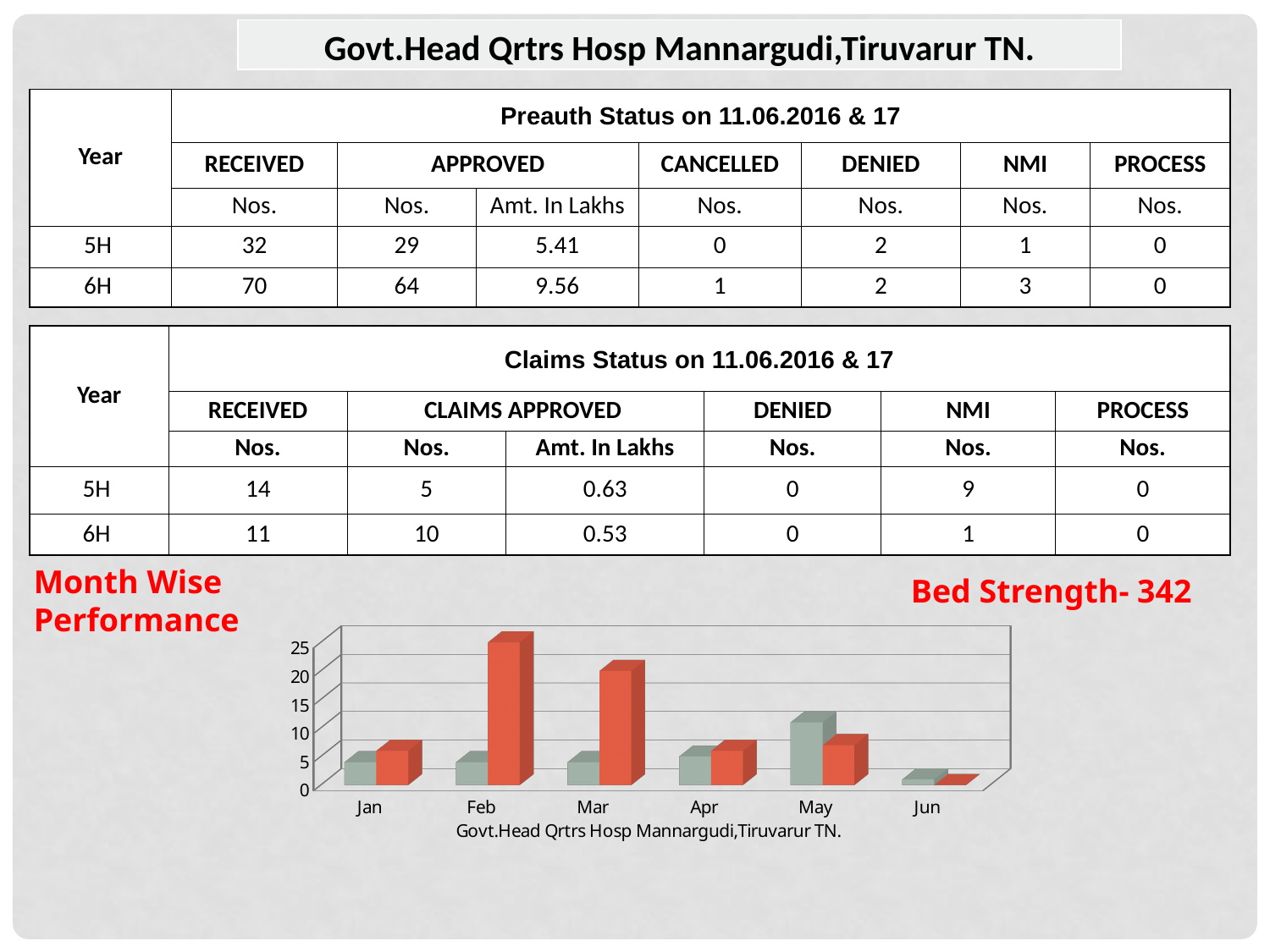
In which month are both bars the lowest? Jun Which month has the larger red bar, Feb or Mar? Feb How many bars are plotted for each month in the bar chart? 2 In which month is the grey bar the tallest? May Is the red bar for Mar greater or less than 15? greater Is the grey bar for Jun greater or less than 5? less Is the red bar for Feb greater or less than 20? greater How many months are shown on the x axis of the bar chart? 6 What kind of chart is shown under 'Month Wise Performance'? bar chart What text appears below the x axis of the bar chart? Govt.Head Qrtrs Hosp Mannargudi,Tiruvarur TN. In which month is the red bar the tallest? Feb